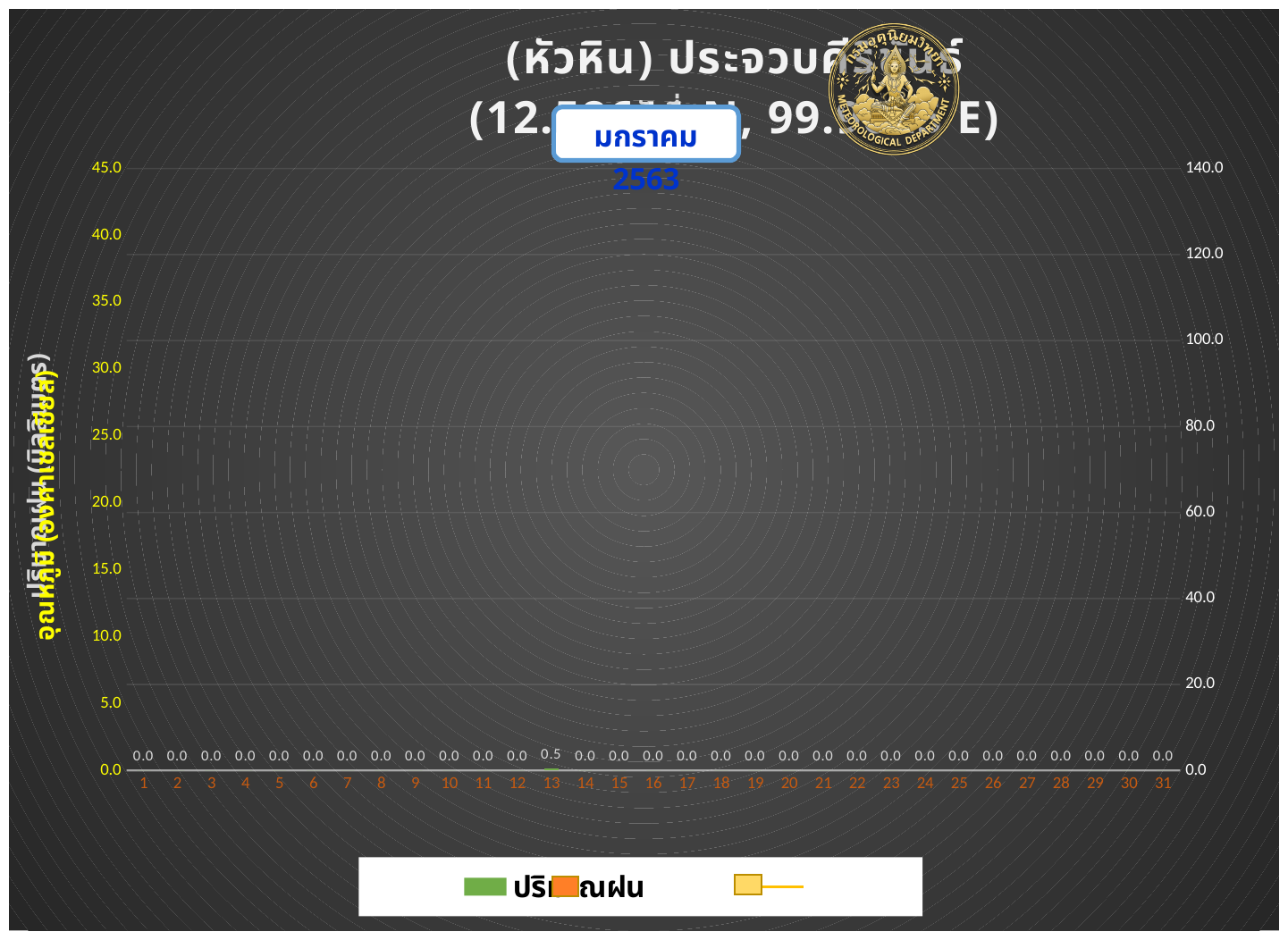
How many days have a value other than 0.0? 1 Is the value for day 13 greater or less than 5.0? less What is the value shown for day 31? 0.0 Which day has the highest value? 13 What is the highest tick label on the left vertical axis? 45.0 What is the difference between the value for day 13 and the value for day 12? 0.5 How many days are shown along the x axis? 31 What is the highest tick label on the right vertical axis? 140.0 What is the value shown for day 1? 0.0 Which is larger, the value for day 13 or the value for day 20? day 13 What is the value shown for day 13? 0.5 What kind of chart is this? bar chart